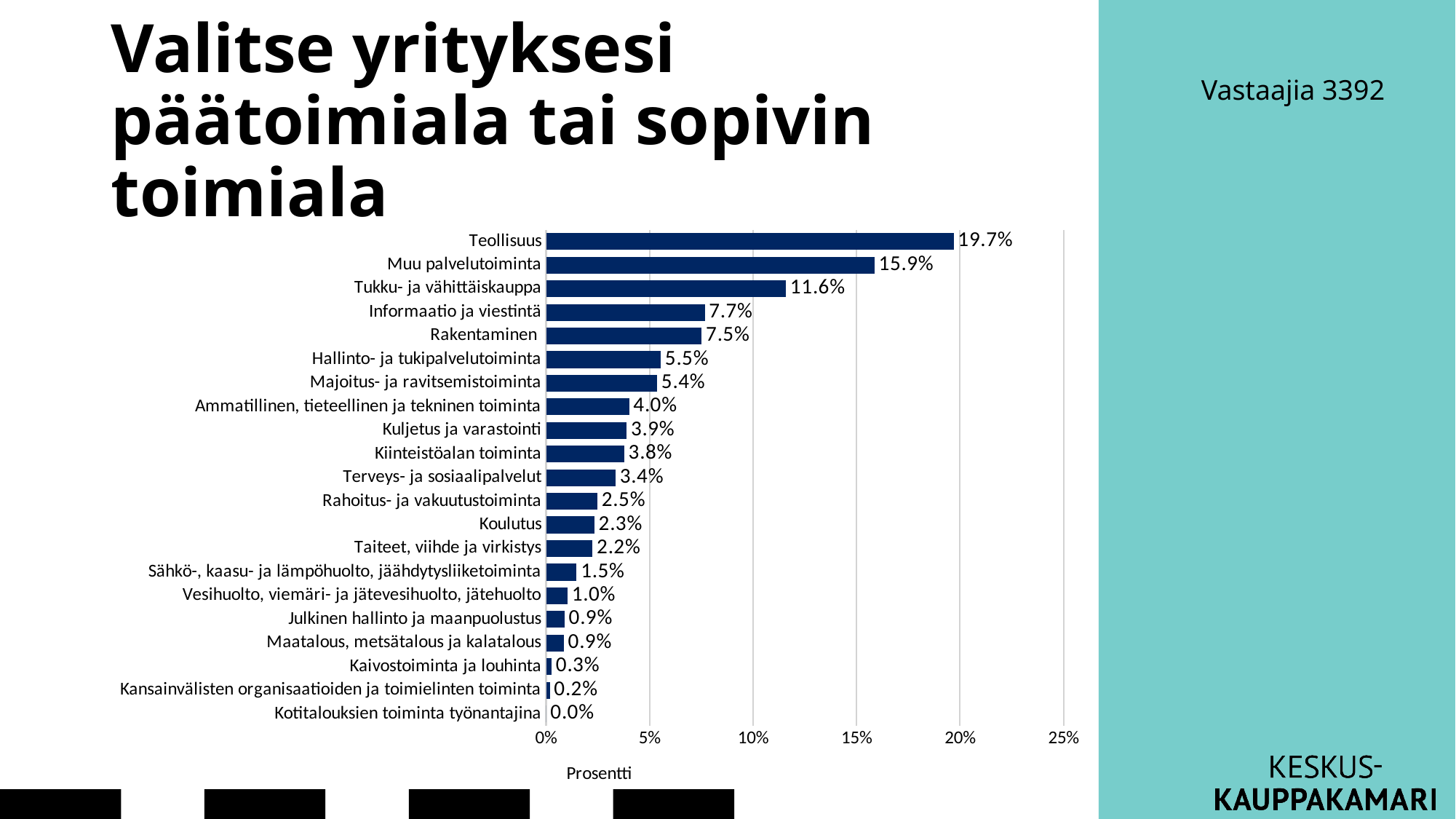
What is the label on the horizontal axis of the chart? Prosentti What is the difference between Teollisuus and Muu palvelutoiminta? 3.8% What is the value for Teollisuus? 19.7% What is the difference between Tukku- ja vähittäiskauppa and Informaatio ja viestintä? 3.9% How many categories are shown in the chart? 21 What is the value for Koulutus? 2.3% Which category has the highest value? Teollisuus Which is larger, Hallinto- ja tukipalvelutoiminta or Terveys- ja sosiaalipalvelut? Hallinto- ja tukipalvelutoiminta What is the value for Rakentaminen? 7.5% Is the value for Tukku- ja vähittäiskauppa greater or less than 10%? greater What kind of chart is shown on the slide? bar chart Which category has the lowest value? Kotitalouksien toiminta työnantajina